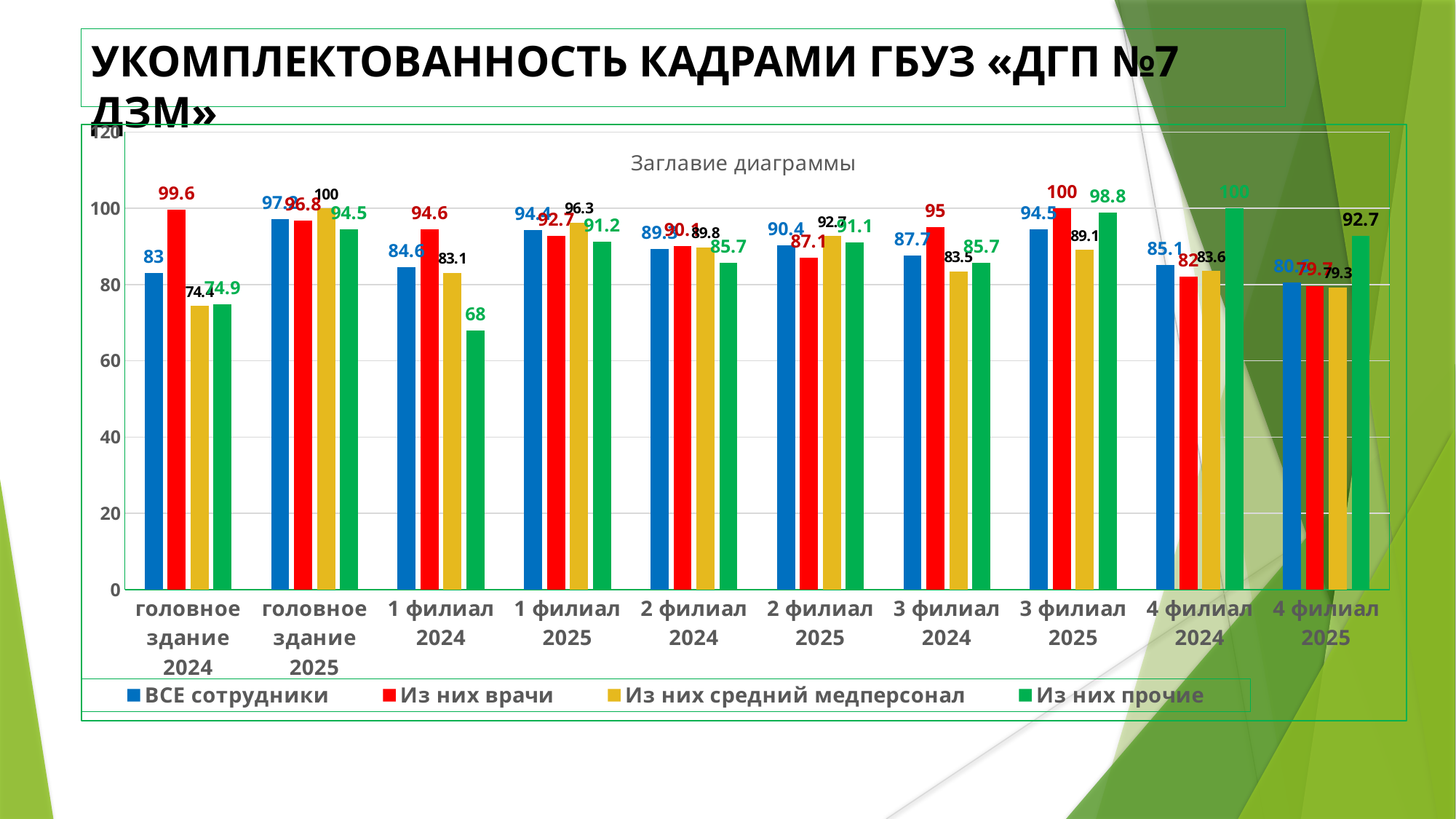
Which colour represents 'Из них врачи' in the legend? red What is the value for 'Из них средний медперсонал' in '1 филиал 2025'? 96.3 What kind of chart is shown on the slide? bar chart Which category has the lowest value for 'Из них прочие'? 1 филиал 2024 What is the difference between 'Из них врачи' and 'Из них средний медперсонал' in 'головное здание 2024'? 25.2 What is the value for 'Из них врачи' in 'головное здание 2024'? 99.6 What is the value for 'Из них прочие' in '1 филиал 2024'? 68 Which is larger in '4 филиал 2024': 'Из них прочие' or 'Из них врачи'? Из них прочие How many categories are shown on the x axis? 10 How many series does the legend list? 4 Is the value for 'Из них средний медперсонал' in '4 филиал 2025' greater or less than 80? less What is the value for 'ВСЕ сотрудники' in '3 филиал 2025'? 94.5